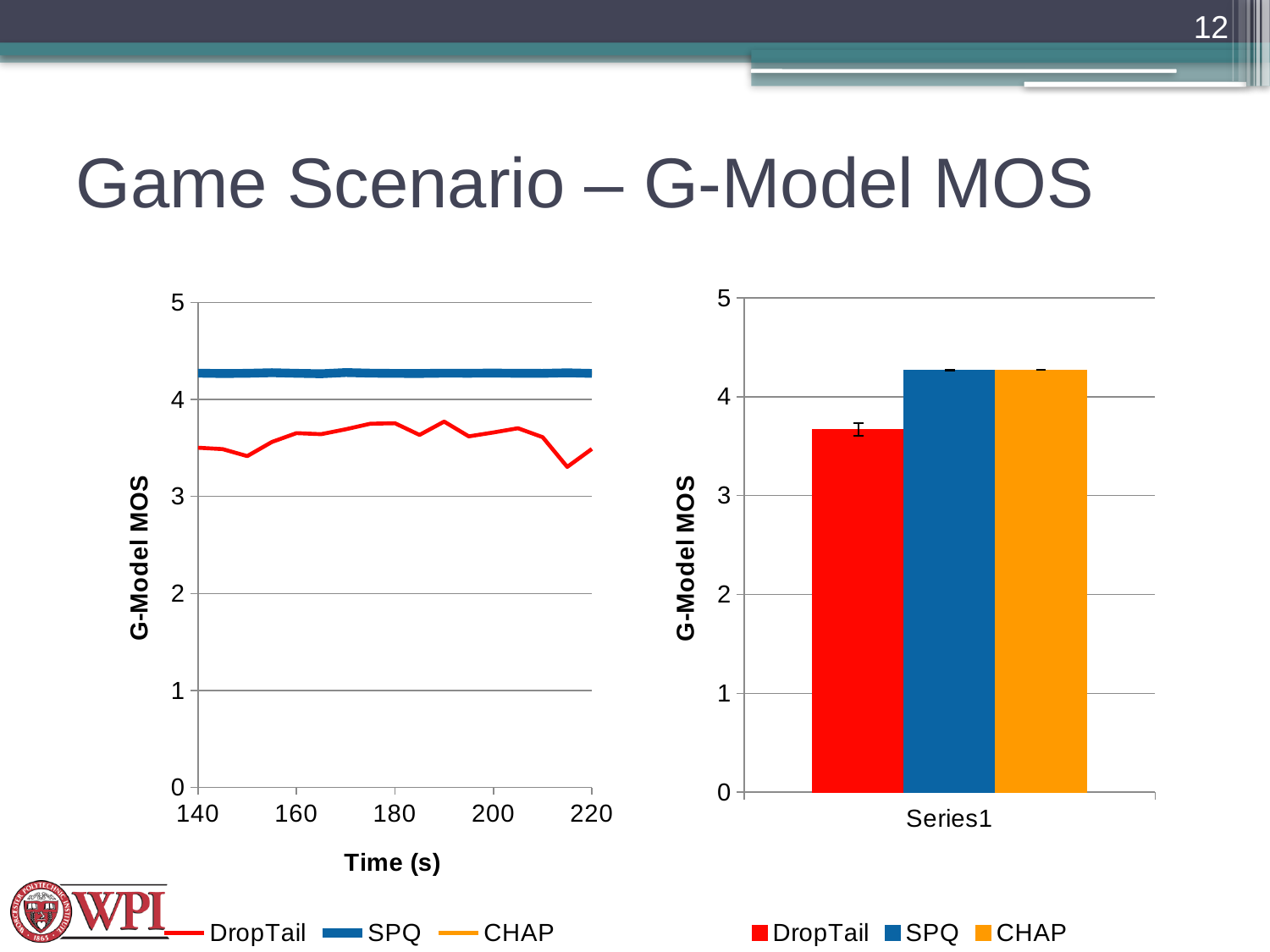
What is the y-axis title of the right chart? G-Model MOS In the left chart, is the SPQ line above or below 4 across the plotted time range? above What kind of chart is the right chart on the slide? bar chart In the right chart, is the value for SPQ greater or less than 4? greater What is the x-axis title of the left chart? Time (s) In the left chart, is the DropTail value at time 160 greater or less than 4? less In the right chart, which is larger, the SPQ bar or the DropTail bar? SPQ In the left chart, how many series does the legend list? 3 What kind of chart is the left chart on the slide? line chart In the right chart, how many series does the legend list? 3 In the right chart, which series has the lowest bar? DropTail